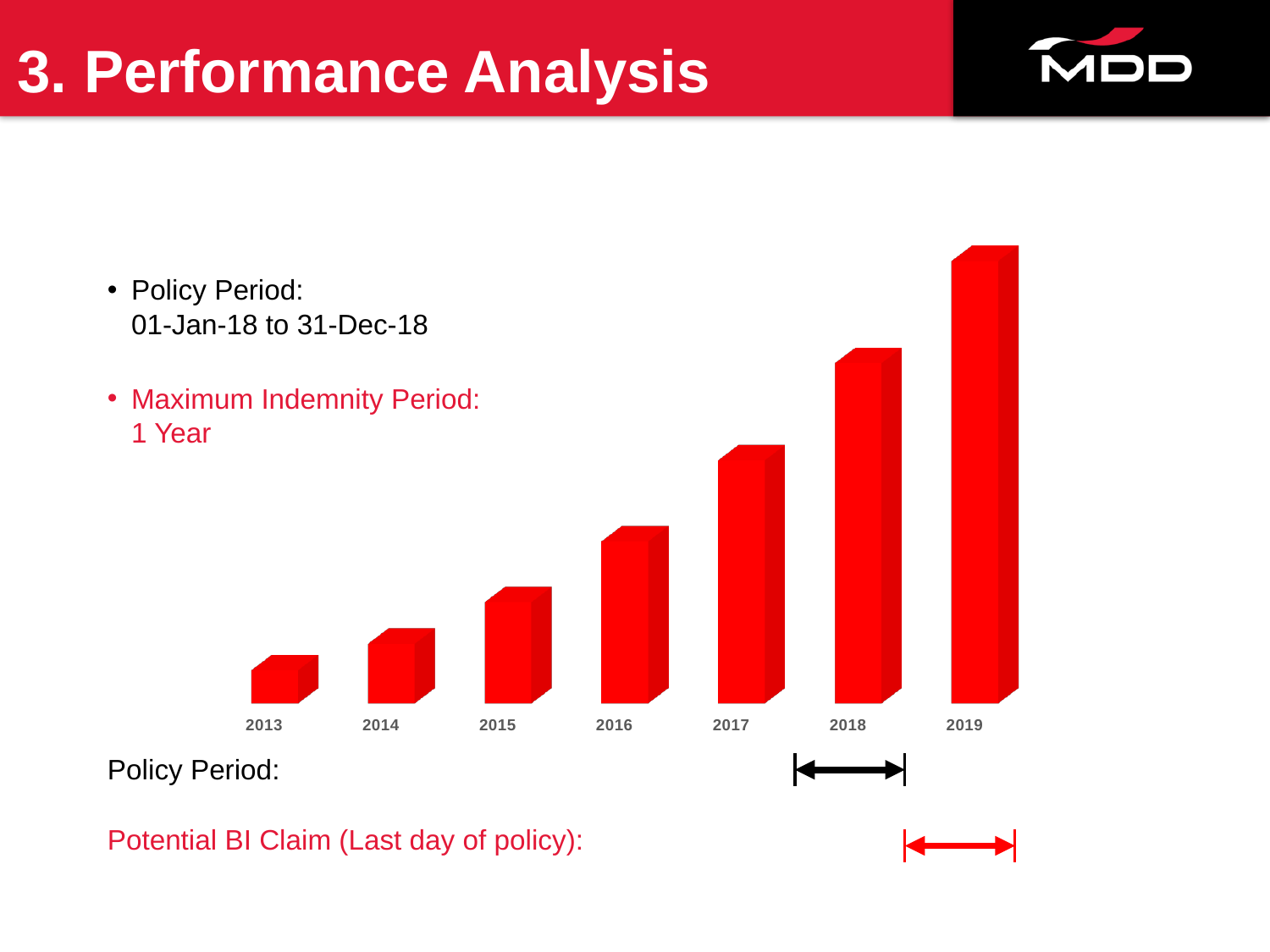
What is the first year shown on the x axis of the chart? 2013 Which bar is shorter, 2016 or 2019? 2016 How many years are shown on the x axis of the chart? 7 Which year has the shortest bar in the chart? 2013 Which year has the tallest bar in the chart? 2019 What colour are the bars in the chart? red Which bar is taller, 2014 or 2017? 2017 Do the bar heights rise or fall from 2013 to 2019? rise Which bar is taller, 2018 or 2015? 2018 What kind of chart is shown on the slide? bar chart